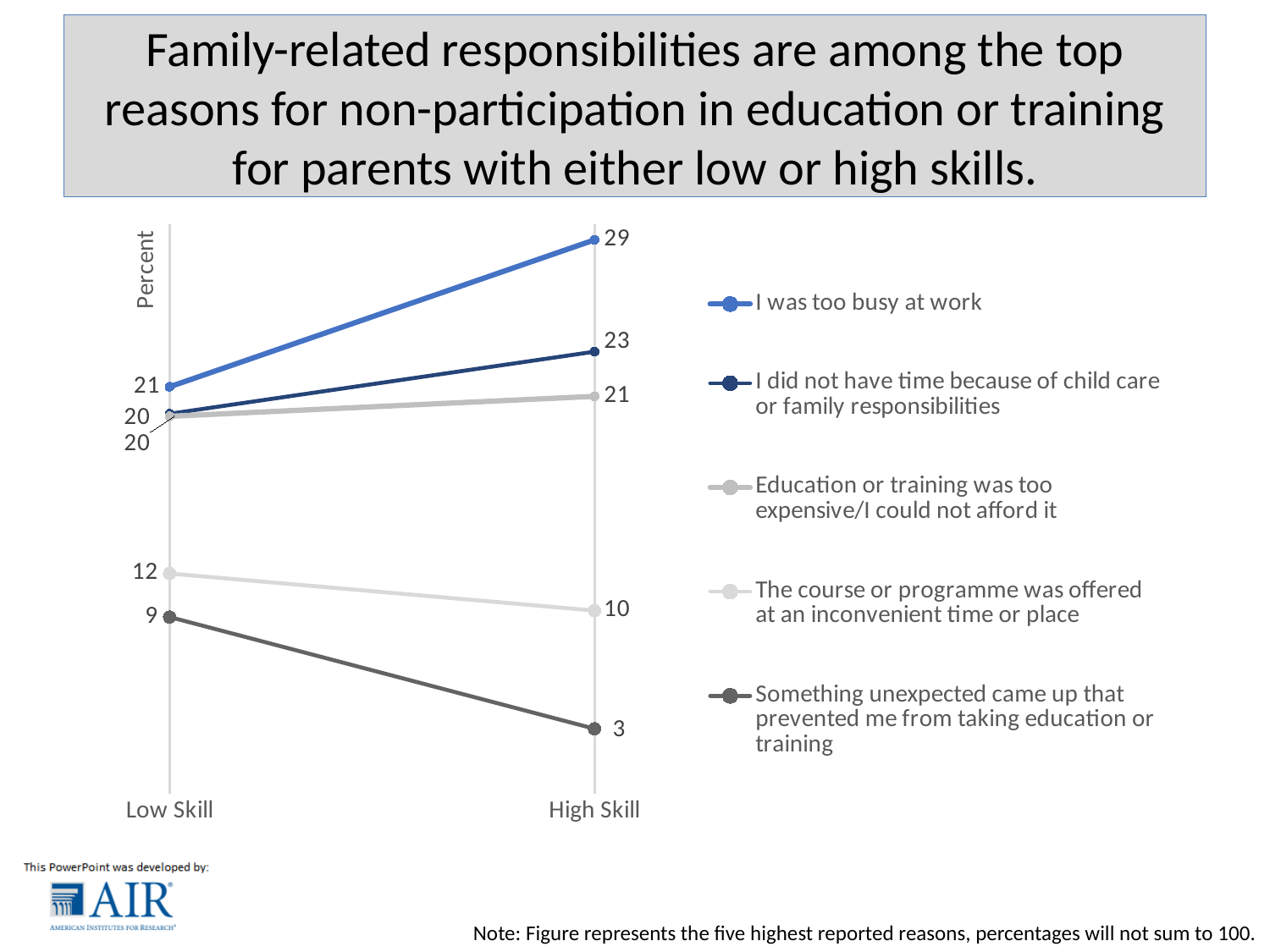
Which is larger at Low Skill: "The course or programme was offered at an inconvenient time or place" or "Something unexpected came up that prevented me from taking education or training"? The course or programme was offered at an inconvenient time or place What is the value for "I did not have time because of child care or family responsibilities" at High Skill? 23 Does the value for "Something unexpected came up that prevented me from taking education or training" rise or fall from Low Skill to High Skill? fall Which series has the lowest value at High Skill? Something unexpected came up that prevented me from taking education or training How many categories are shown on the x axis? 2 How many series does the legend list? 5 What is the value for "I was too busy at work" at High Skill? 29 What type of chart is shown on the slide? line chart Which series has the highest value at High Skill? I was too busy at work What is the value for "Something unexpected came up that prevented me from taking education or training" at Low Skill? 9 What is the value for "The course or programme was offered at an inconvenient time or place" at High Skill? 10 What is the difference between the High Skill and Low Skill values for "I was too busy at work"? 8